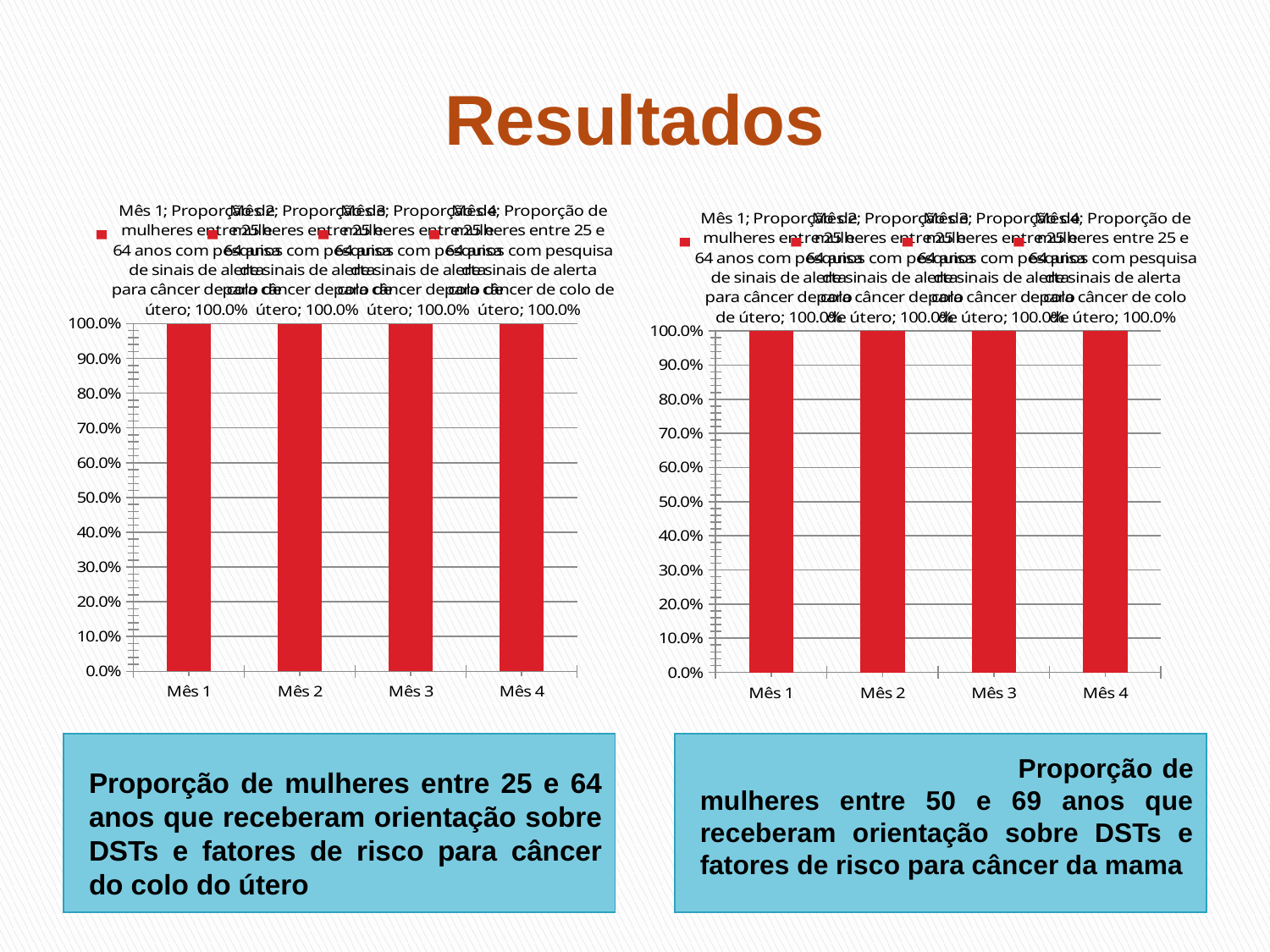
In the left chart, what is the value for Mês 1? 100.0% In the right chart, what is the value for Mês 2? 100.0% How many bars are plotted in the right chart? 4 In the right chart, is the value for Mês 1 greater or less than 90.0%? greater In the left chart, what is the value for Mês 4? 100.0% What kind of chart is the left chart? bar chart How many categories are shown on the x axis of the left chart? 4 In the left chart, what is the difference between the values for Mês 2 and Mês 3? 0.0% In the right chart, what is the value for Mês 3? 100.0% In the left chart, do the values rise, fall or stay the same from Mês 1 to Mês 4? stay the same What is the highest tick value shown on the y axis of the right chart? 100.0% What kind of chart is the right chart? bar chart